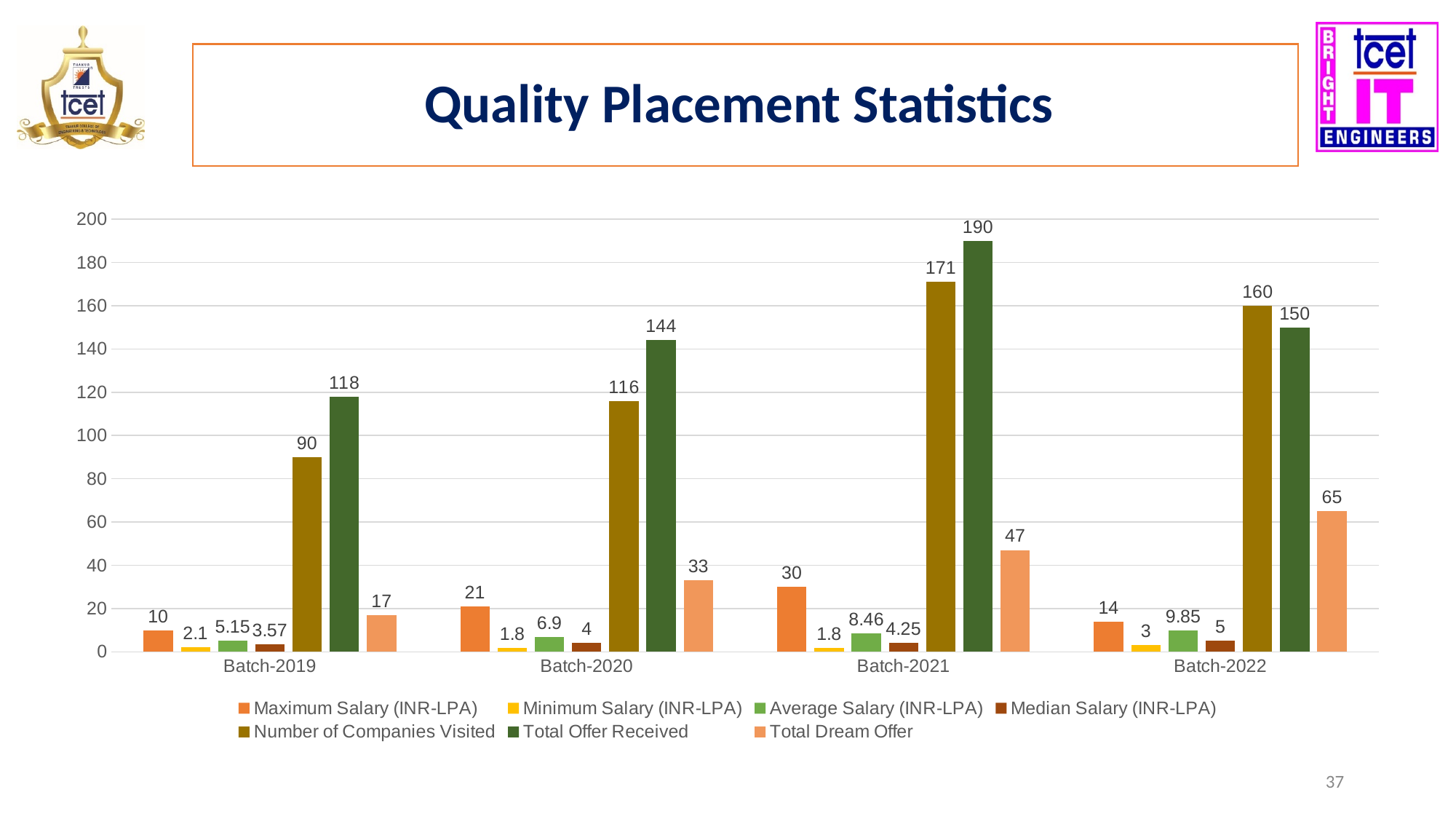
What is the difference between the Number of Companies Visited for Batch-2021 and Batch-2020? 55 What is the Total Offer Received for Batch-2021? 190 What kind of chart is shown on the slide? Bar chart Which batch has the lowest Total Offer Received? Batch-2019 How many series does the legend list? 7 Which is larger for Batch-2022: Number of Companies Visited or Total Offer Received? Number of Companies Visited Which batch has the highest Maximum Salary (INR-LPA)? Batch-2021 How many batches are shown on the x axis? 4 What is the Average Salary (INR-LPA) for Batch-2022? 9.85 What is the title of the slide? Quality Placement Statistics What is the Number of Companies Visited for Batch-2019? 90 What is the Total Dream Offer for Batch-2020? 33